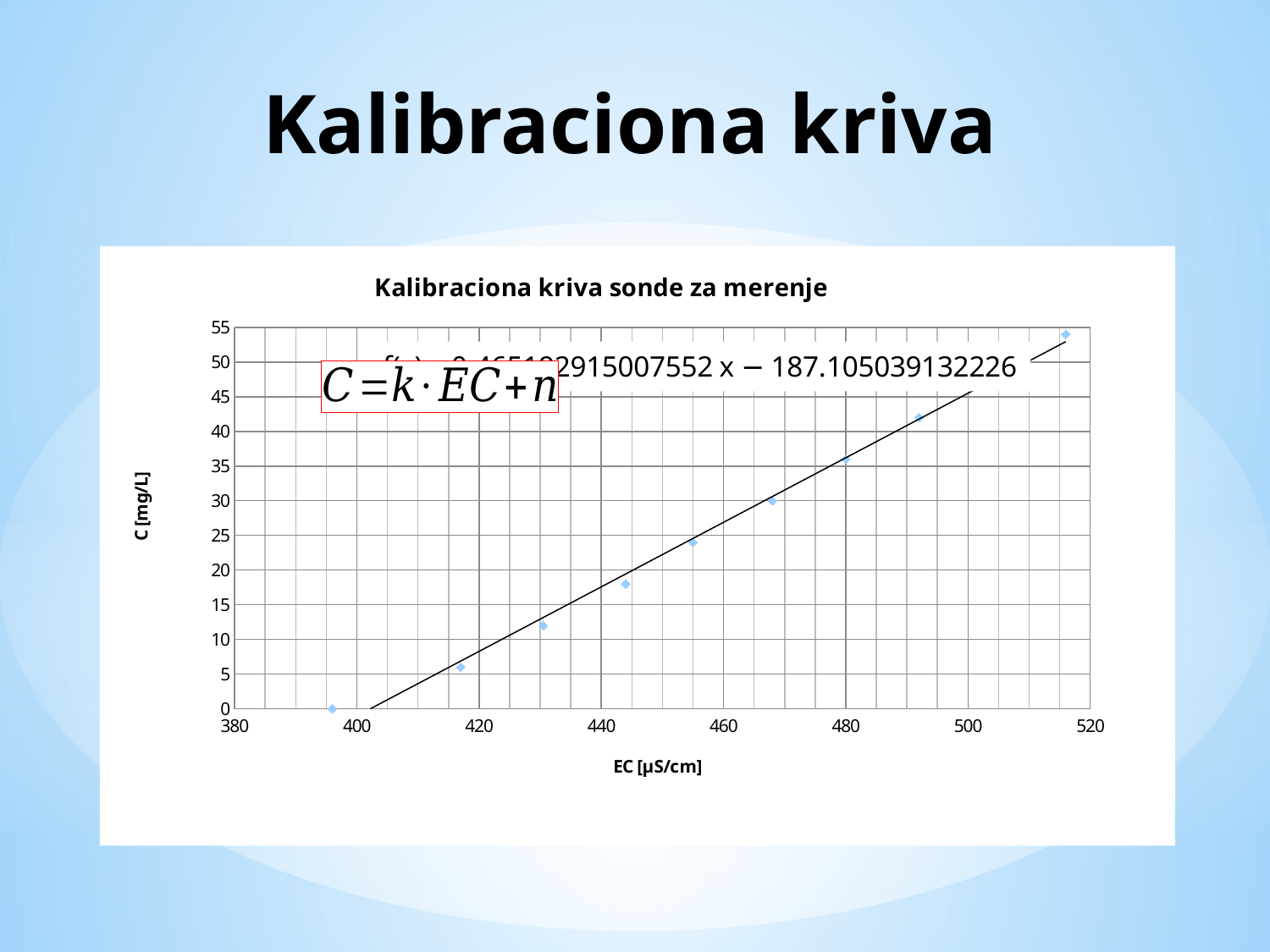
Is the C value of the data point nearest EC = 480 greater or less than 30? greater Is the C value of the rightmost data point greater or less than 50? greater Do the C values rise or fall as EC increases along the x axis? Rise Which data point has the highest C value, the one at the lowest EC or the one at the highest EC? The one at the highest EC Which has the larger C value: the data point nearest EC = 440 or the data point nearest EC = 500? The data point nearest EC = 500 Is the C value of the data point nearest EC = 420 greater or less than 10? less What is the title of the chart? Kalibraciona kriva sonde za merenje What kind of chart is shown on the slide? Scatter chart with a trend line What is the label of the x axis of the chart? EC [µS/cm]